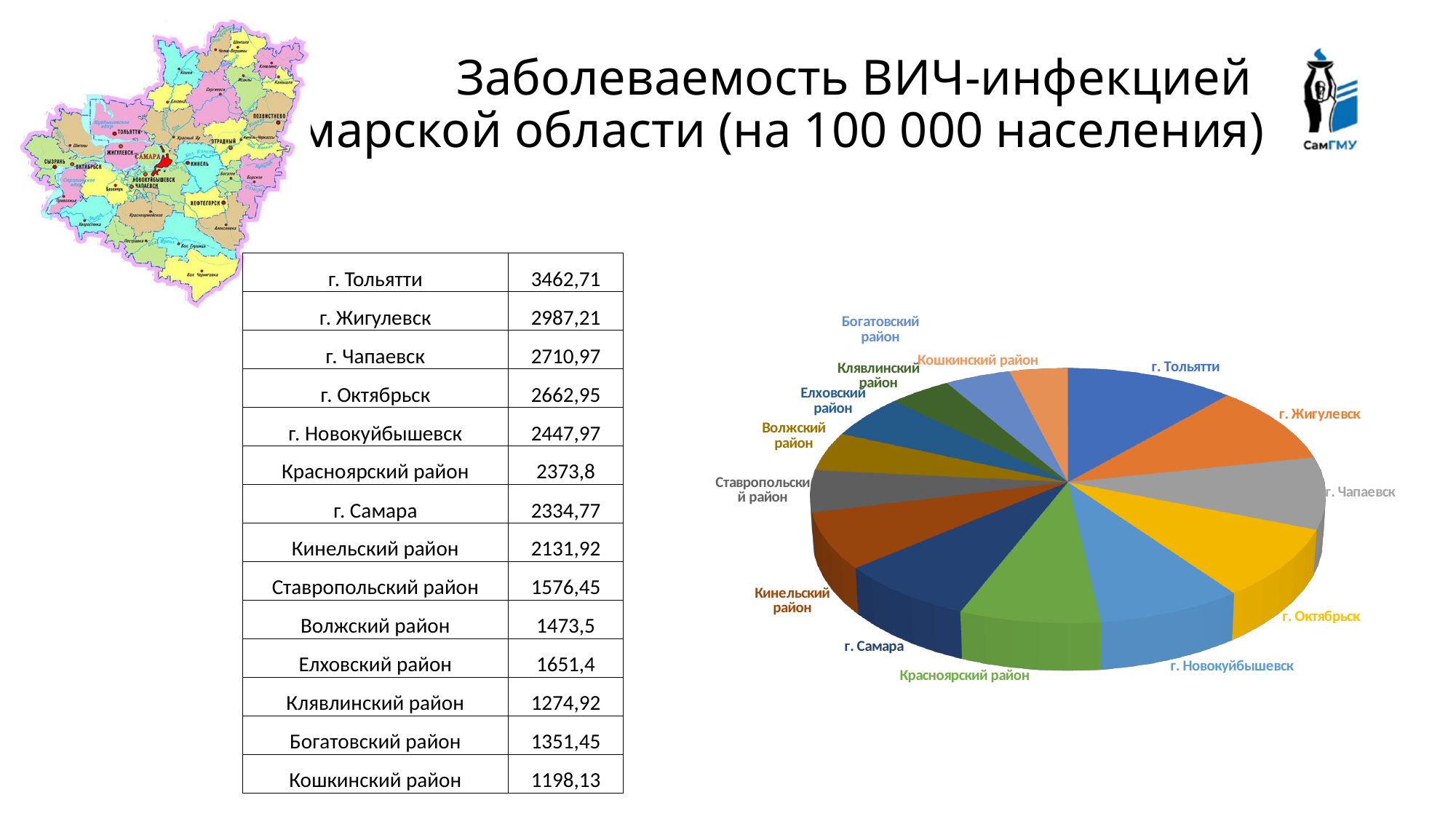
How many categories (territories) does the pie chart show? 14 Which has the larger value, Кинельский район or Клявлинский район? Кинельский район Which has the larger value, г. Тольятти or г. Самара? г. Тольятти What is the difference between the values for г. Тольятти and г. Жигулевск? 475,5 What kind of chart is shown on the slide? pie chart Which territory has the highest HIV incidence value on the slide? г. Тольятти Which territory has the lowest HIV incidence value on the slide? Кошкинский район What is the HIV incidence value for Волжский район? 1473,5 What is the HIV incidence value for г. Новокуйбышевск? 2447,97 What is the HIV incidence value for Елховский район? 1651,4 What colour is the г. Октябрьск slice in the pie chart? yellow What is the HIV incidence value for г. Тольятти? 3462,71